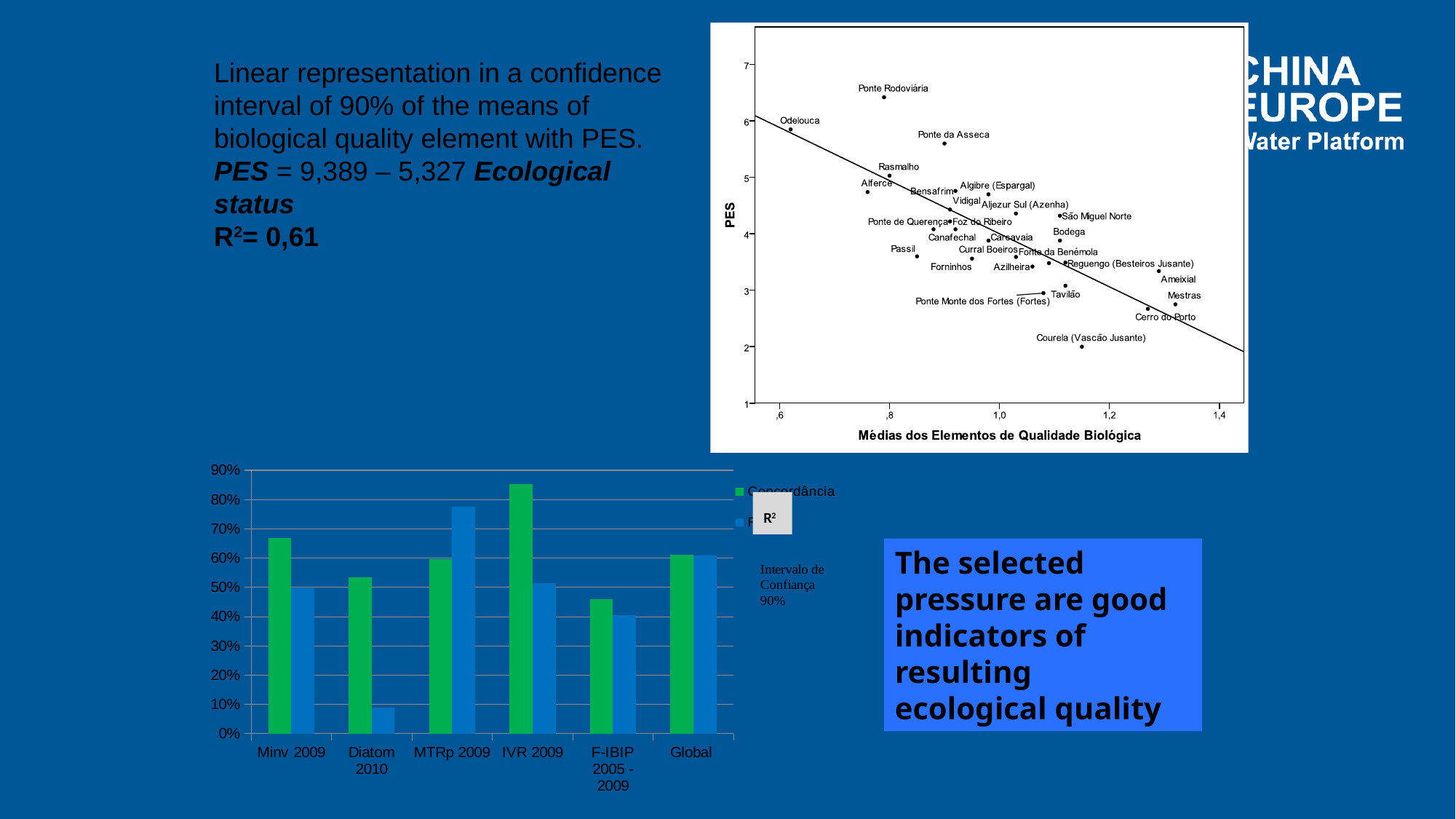
In the bottom-left bar chart, which category has the highest Concordância (green) bar? IVR 2009 In the bottom-left bar chart, which category has the lowest Concordância (green) bar? F-IBIP 2005 - 2009 In the bottom-left bar chart, which category has the lowest blue bar? Diatom 2010 In the bottom-left bar chart, which category has the highest blue bar? MTRp 2009 In the top-right scatter plot, what is the title of the x axis? Médias dos Elementos de Qualidade Biológica In the bottom-left bar chart, how many categories are shown on the x axis? 6 What kind of chart is the one at the bottom left of the slide? bar chart In the top-right scatter plot, which labelled point has the lowest PES value? Courela (Vascão Jusante) In the bottom-left bar chart, is the Concordância (green) value for IVR 2009 greater or less than 80%? greater What kind of chart is the one at the top right of the slide? scatter plot In the bottom-left bar chart, is the blue bar for Diatom 2010 greater or less than 20%? less In the bottom-left bar chart, for Minv 2009, which bar is larger, the green one or the blue one? the green one